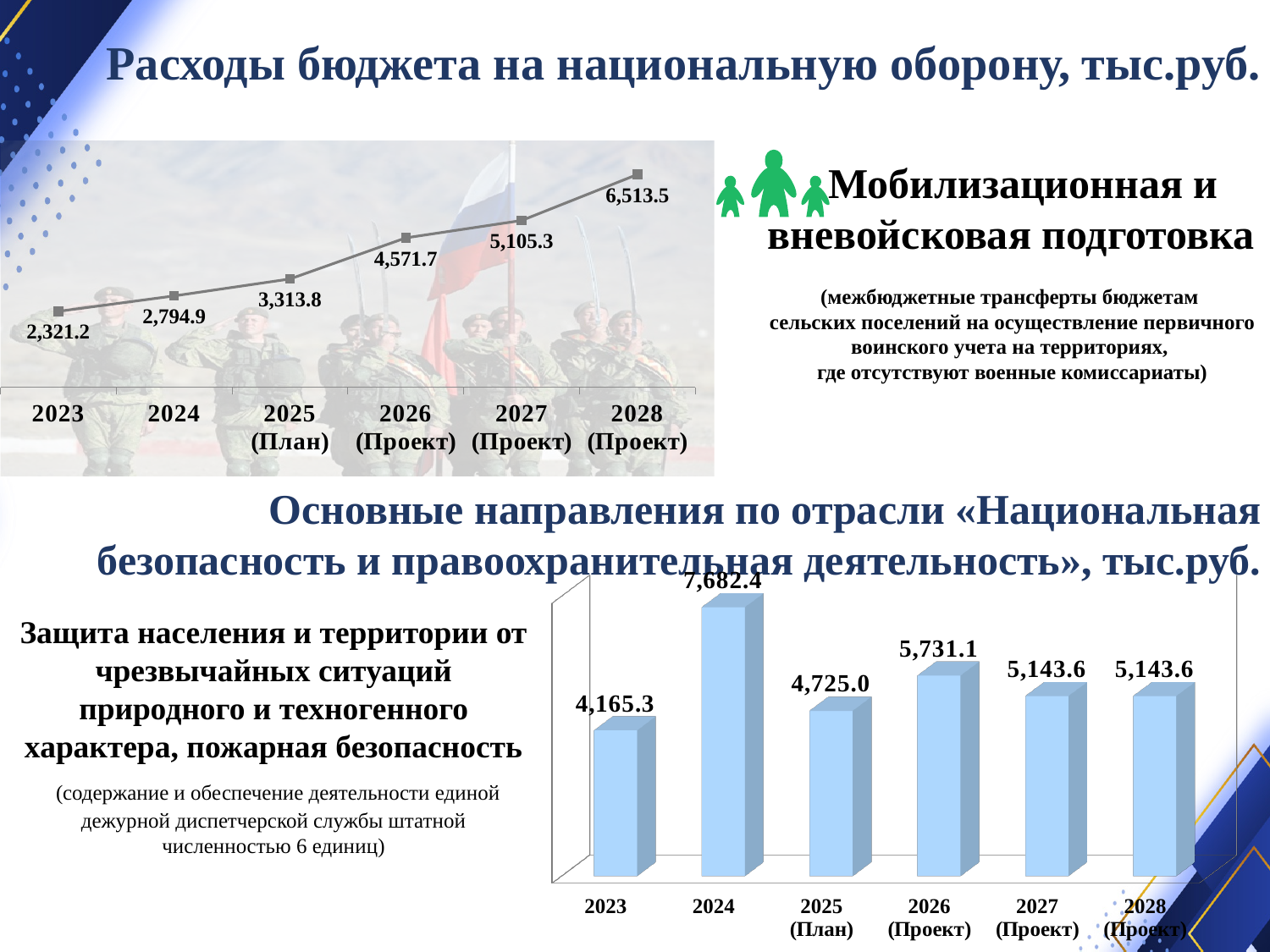
In the top line chart on the slide, which year has the lowest value? 2023 In the bottom bar chart on the slide, which year has the lowest value? 2023 In the bottom bar chart on the slide, which year has the highest value? 2024 What kind of chart is the top chart on the slide? line chart In the top line chart on the slide, do the values rise or fall from 2023 to 2028? rise How many bars are shown in the bottom bar chart on the slide? 6 In the top line chart on the slide, what is the value for 2023? 2,321.2 In the bottom bar chart on the slide, what is the difference between the values for 2024 and 2023? 3,517.1 In the bottom bar chart on the slide, which is larger: the value for 2026 (Проект) or the value for 2025 (План)? 2026 (Проект) In the bottom bar chart on the slide, what is the value for 2024? 7,682.4 In the top line chart on the slide, what is the difference between the values for 2026 (Проект) and 2025 (План)? 1,257.9 In the top line chart on the slide, what is the value for 2028 (Проект)? 6,513.5